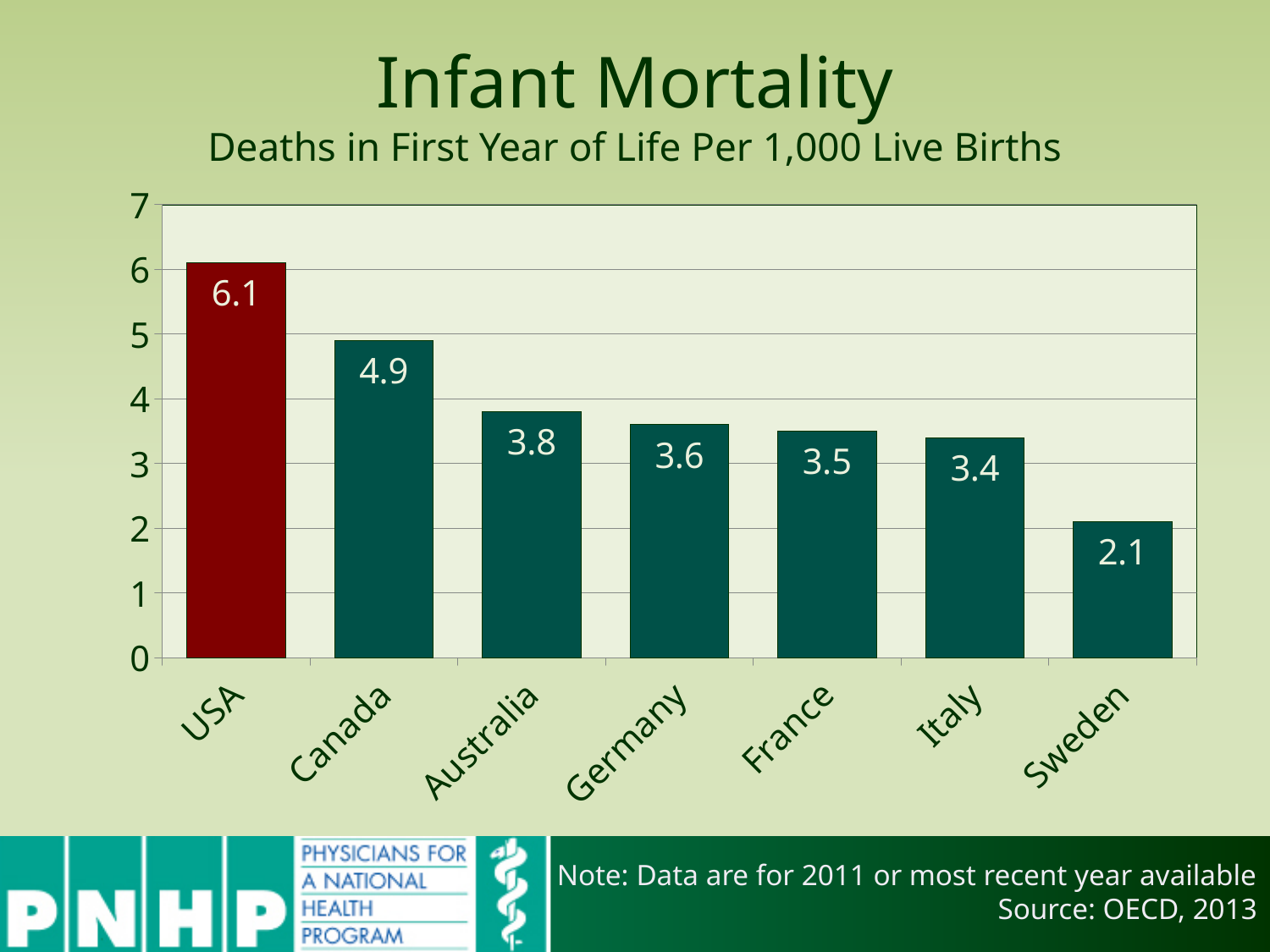
What type of chart is shown on the slide? Bar chart What is the difference between the infant mortality rates of the USA and Sweden? 4.0 Which country has the highest infant mortality rate? USA Which country has the lowest infant mortality rate? Sweden What is the infant mortality rate for Sweden? 2.1 What is the infant mortality rate for Germany? 3.6 How many countries are shown in the chart? 7 What is the difference between the infant mortality rates of the USA and Canada? 1.2 What is the infant mortality rate for the USA? 6.1 Which has a higher infant mortality rate, Australia or Italy? Australia Which bar is coloured differently (dark red) from the others? USA What is the infant mortality rate for Canada? 4.9